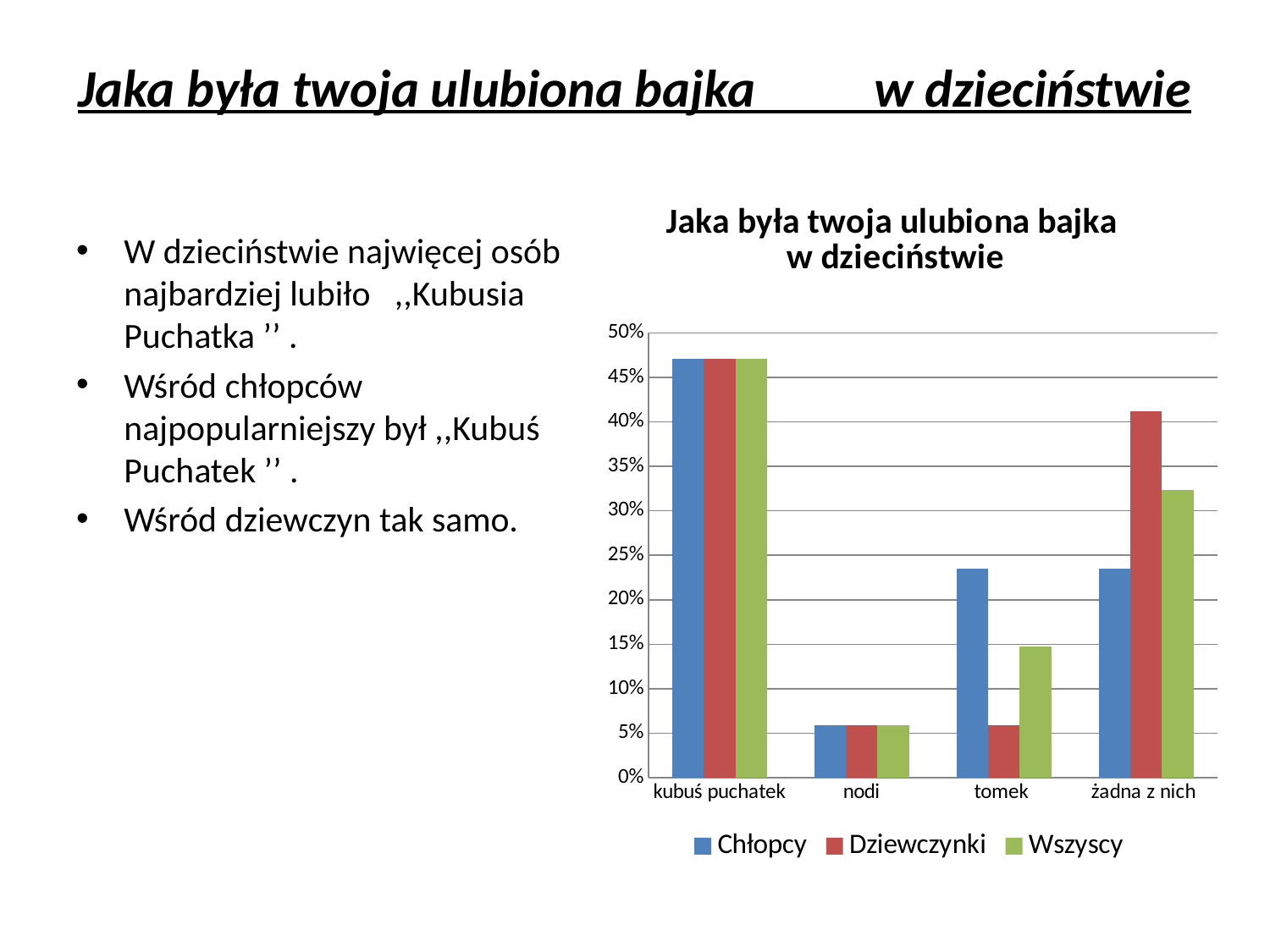
Which category has the highest value for the Chłopcy series? kubuś puchatek Which category has the highest value for the Dziewczynki series? kubuś puchatek For the category żadna z nich, which series has the larger value: Chłopcy or Dziewczynki? Dziewczynki Is the value for Chłopcy in the category tomek greater or less than 20%? greater For the category tomek, which series has the larger value: Chłopcy or Dziewczynki? Chłopcy What is the title of the chart? Jaka była twoja ulubiona bajka w dzieciństwie Which category has the lowest value for the Chłopcy series? nodi How many categories are shown on the x axis of the chart? 4 What kind of chart is shown on the slide? bar chart How many series does the chart legend list? 3 Which category has the lowest value for the Wszyscy series? nodi Is the value for Wszyscy in the category żadna z nich greater or less than 30%? greater